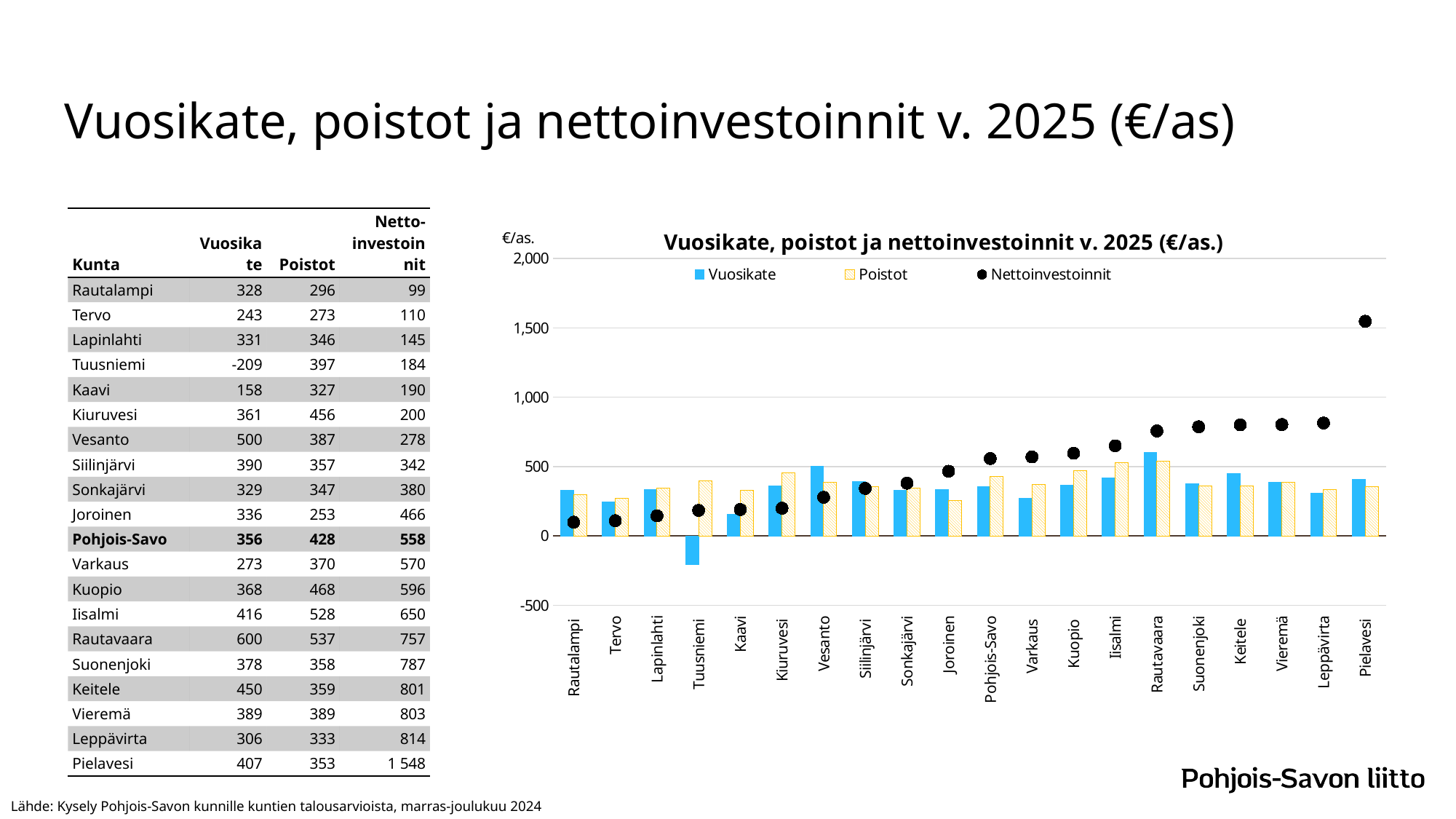
Which municipality has the highest Nettoinvestoinnit? Pielavesi For Rautavaara, which is larger: Vuosikate or Poistot? Vuosikate What is the difference between Poistot and Vuosikate for Kiuruvesi? 95 How many series does the chart legend list? 3 What is the Nettoinvestoinnit value for Pielavesi? 1 548 Is the Nettoinvestoinnit value for Pielavesi greater or less than 1,500? greater Do the Nettoinvestoinnit values rise or fall from left to right along the x axis? rise Which municipality has the highest Vuosikate? Rautavaara Which municipality has the lowest Vuosikate? Tuusniemi How many municipalities (categories) are shown on the x axis of the chart? 20 What is the Vuosikate value for Kuopio? 368 What kind of chart is shown on the slide? bar chart (with dot markers for Nettoinvestoinnit)